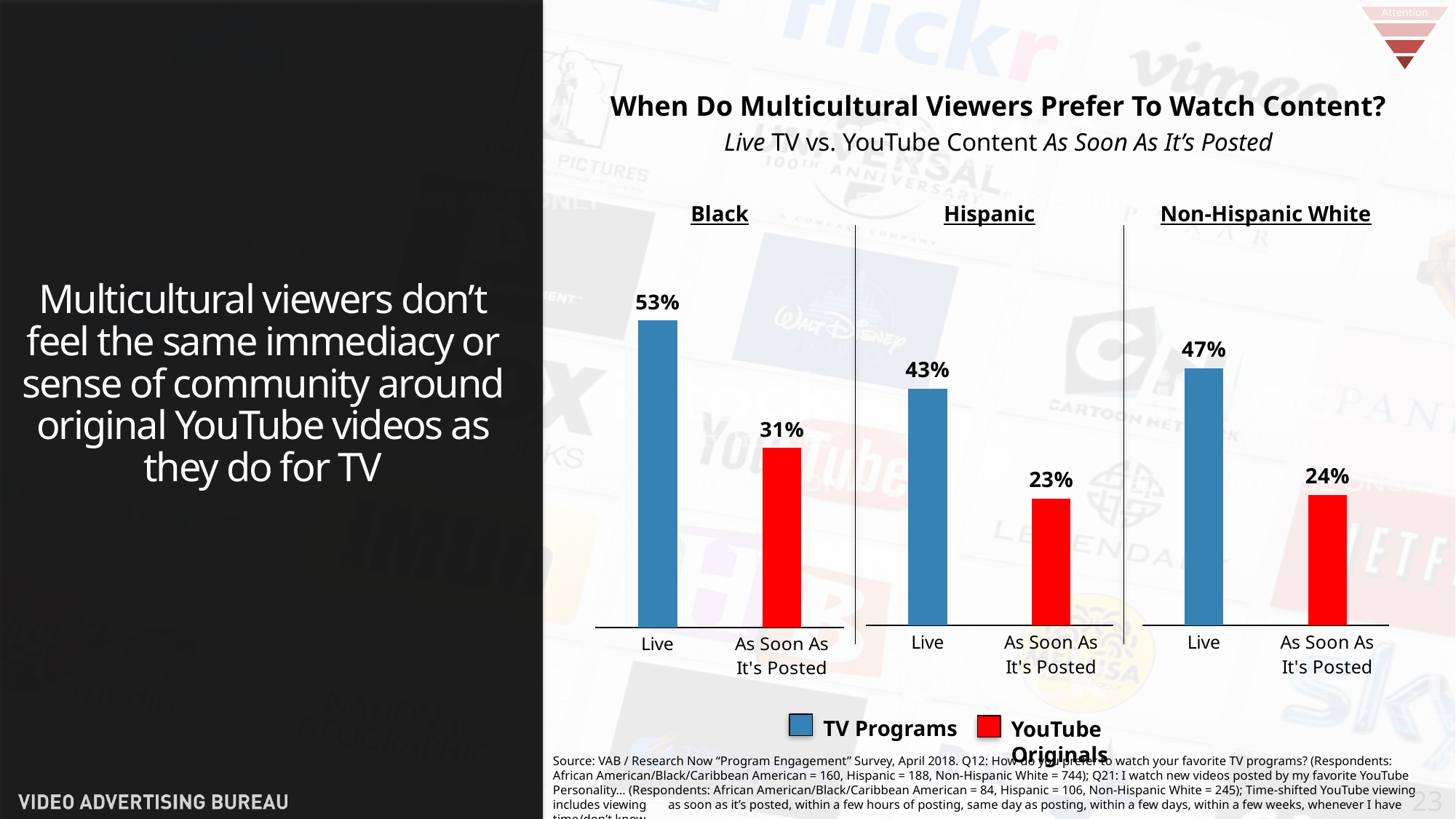
What kind of chart is shown on the slide? Bar chart What percentage of Black viewers prefer to watch TV programs live? 53% What is the difference between the Live and As Soon As It's Posted values for Hispanic viewers? 20 percentage points What percentage of Hispanic viewers watch YouTube originals as soon as they are posted? 23% What is the value for Black viewers who watch YouTube originals as soon as they are posted? 31% What colour represents YouTube Originals in the legend? Red Which group has the lowest percentage for watching YouTube originals as soon as they are posted? Hispanic Which group has the highest percentage for watching TV programs live? Black What is the difference between the Live values for Black and Non-Hispanic White viewers? 6 percentage points What is the value for Non-Hispanic White viewers who prefer to watch TV programs live? 47% Which is larger for Non-Hispanic White viewers: the Live value or the As Soon As It's Posted value? Live How many series does the legend list? 2